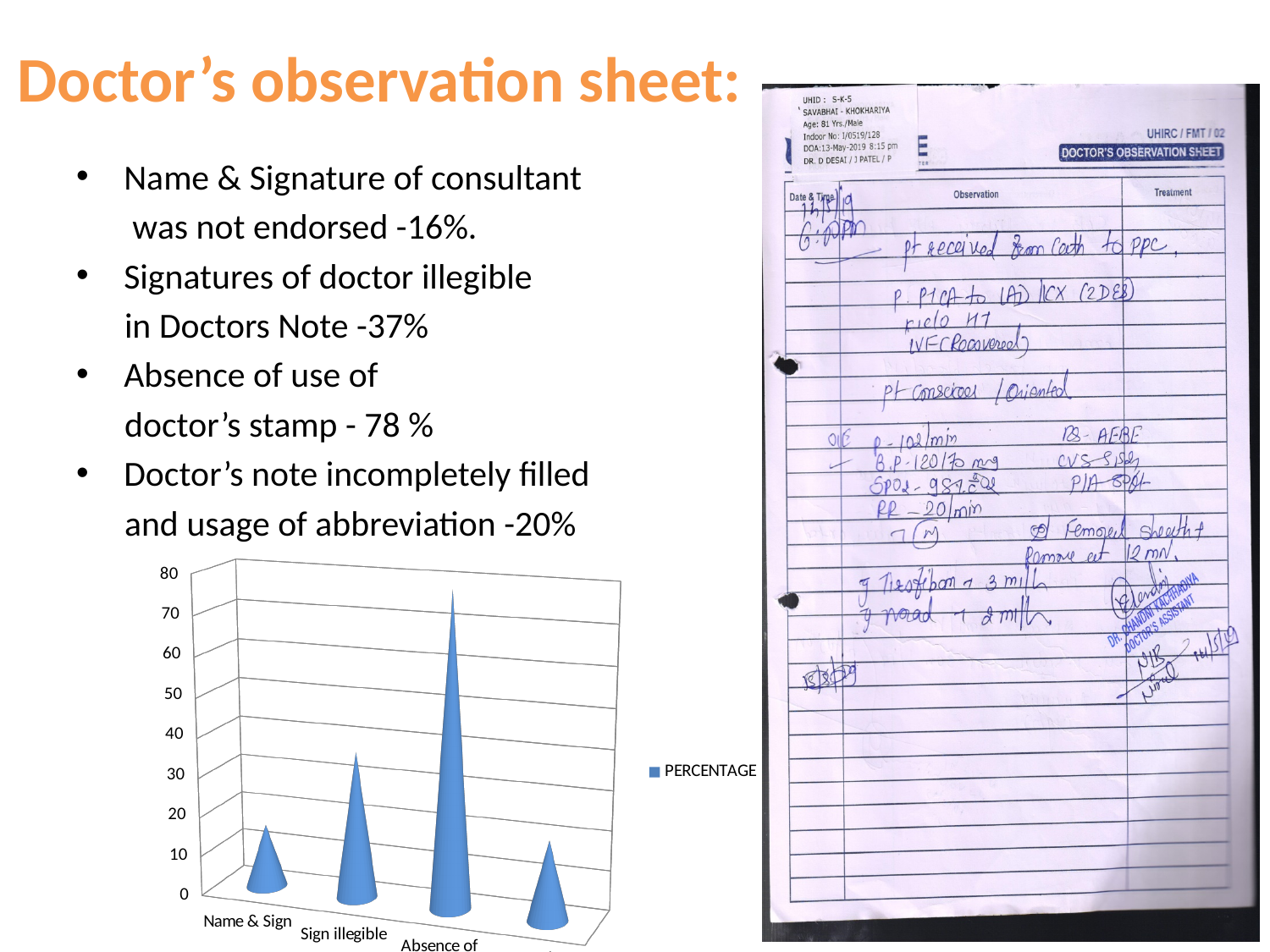
Which category has the highest value in the chart? Absence of Which is larger, the value for Absence of or the value for Sign illegible? Absence of Is the value for Name & Sign greater or less than 30? less What kind of chart is shown on the slide? bar chart Which is larger, the value for Sign illegible or the value for Name & Sign? Sign illegible What is the name of the series shown in the chart legend? PERCENTAGE Is the value for Sign illegible greater or less than 20? greater What is the highest value shown on the chart's vertical axis? 80 How many series does the chart legend list? 1 Is the value for Absence of greater or less than 60? greater How many categories are plotted in the chart? 4